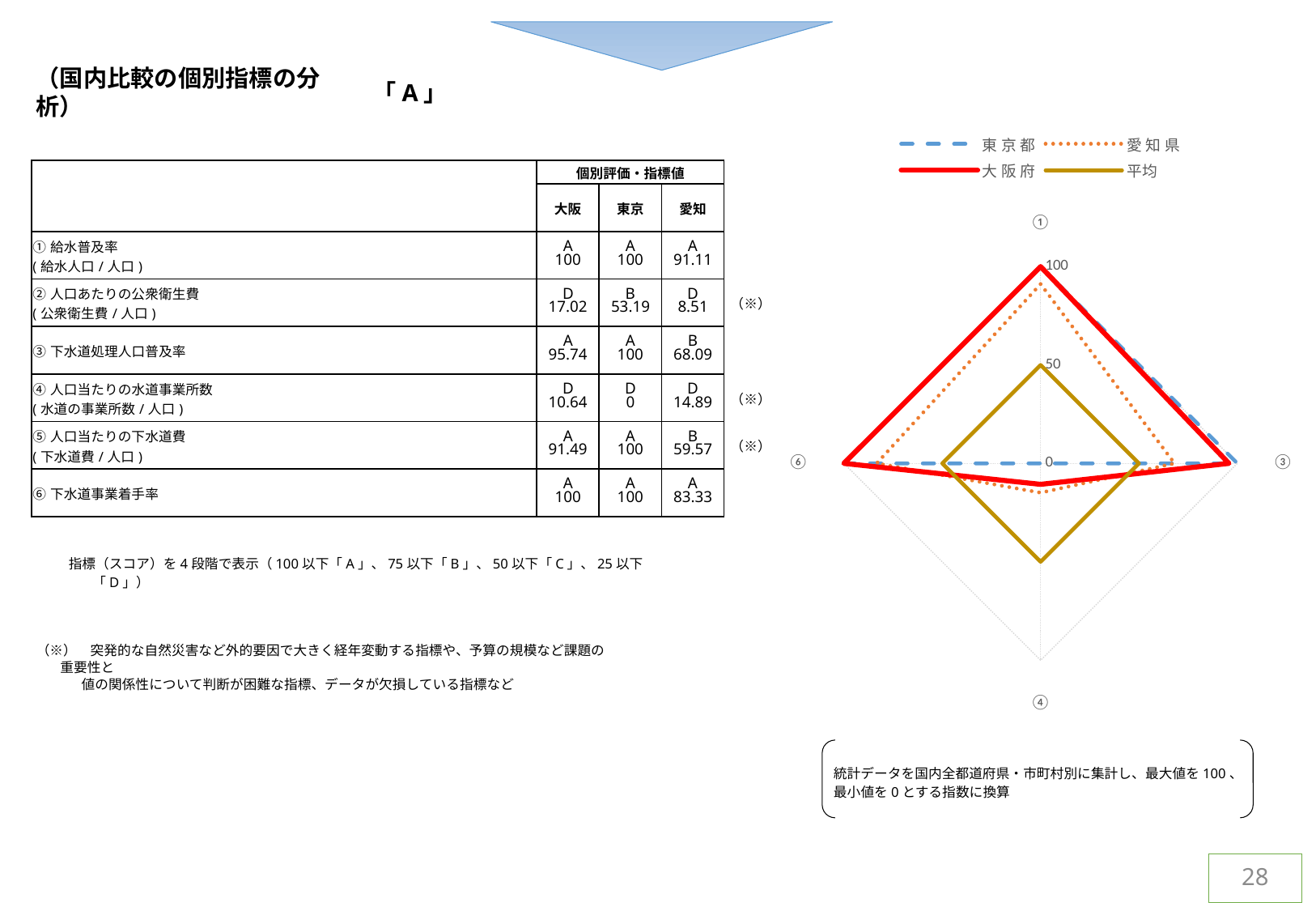
What is the value for 東京都 on axis ④ of the radar chart? 0 Is the value for 大阪府 on axis ④ greater or less than 50? less On axis ③ of the radar chart, which is larger, 東京都 or 愛知県? 東京都 Is the value for 愛知県 on axis ③ greater or less than 50? greater What is the value for 大阪府 on axis ① of the radar chart? 100 What kind of chart is shown on the slide? radar chart On axis ④ of the radar chart, which series has the highest value? 平均 How many numbered axes are labelled on the radar chart? 4 Is the value for 平均 on axis ① greater or less than 100? less How many series does the legend of the radar chart list? 4 What is the highest tick value shown on the radar chart's axis? 100 Which series are listed in the legend of the radar chart? 東京都, 愛知県, 大阪府, 平均